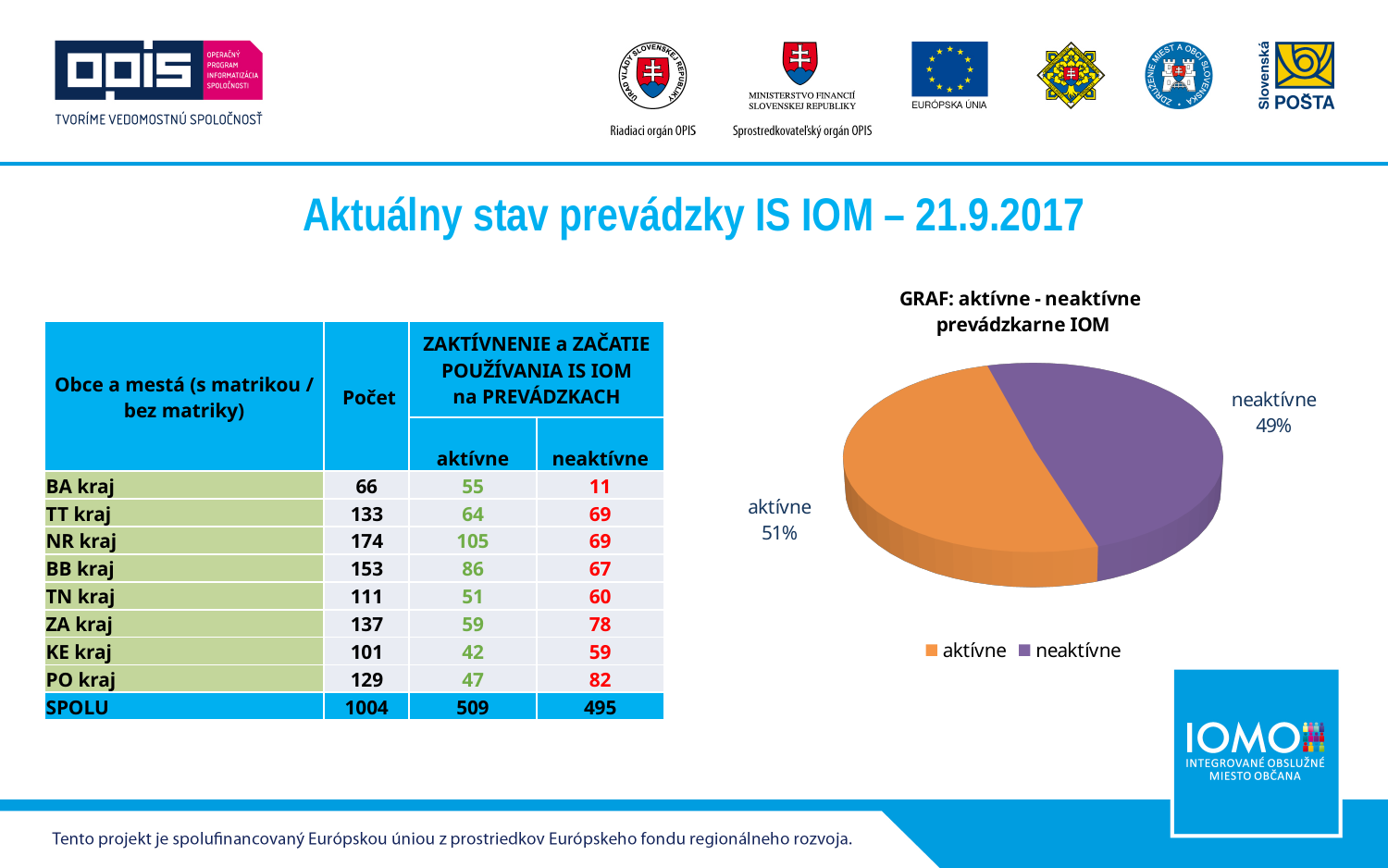
How many slices does the pie chart have? 2 Is the share for 'aktívne' greater or less than 50%? greater What share of the pie does the 'aktívne' slice represent? 51% What colour is the 'neaktívne' slice in the pie chart? purple Which is larger in the pie chart, 'aktívne' or 'neaktívne'? aktívne Which slice of the pie chart is the smallest? neaktívne What is the difference in percentage points between the 'aktívne' and 'neaktívne' slices? 2 percentage points What share of the pie does the 'neaktívne' slice represent? 49% How many entries does the chart legend list? 2 Which slice of the pie chart is the largest? aktívne What is the title of the pie chart? GRAF: aktívne - neaktívne prevádzkarne IOM What kind of chart is shown on the slide? pie chart